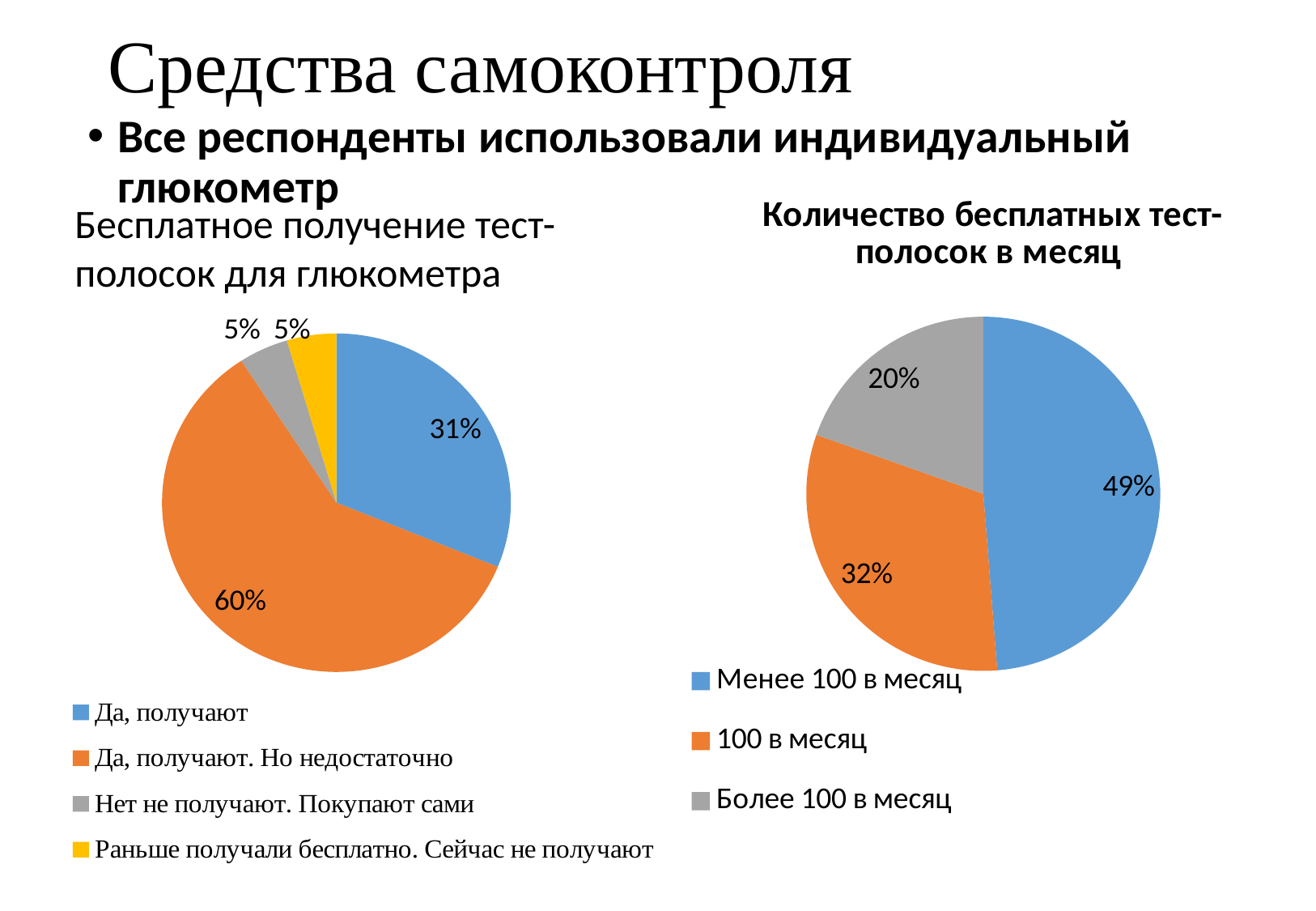
In the left chart 'Бесплатное получение тест-полосок для глюкометра', what share of respondents answered 'Да, получают'? 31% In the left chart 'Бесплатное получение тест-полосок для глюкометра', how many categories does the legend list? 4 In the right chart 'Количество бесплатных тест-полосок в месяц', which is larger: the share for '100 в месяц' or for 'Более 100 в месяц'? 100 в месяц In the left chart 'Бесплатное получение тест-полосок для глюкометра', what is the difference between the shares for 'Да, получают. Но недостаточно' and 'Да, получают'? 29% In the right chart 'Количество бесплатных тест-полосок в месяц', what share of respondents receive '100 в месяц'? 32% In the left chart 'Бесплатное получение тест-полосок для глюкометра', what share of respondents answered 'Нет не получают. Покупают сами'? 5% In the right chart 'Количество бесплатных тест-полосок в месяц', what colour is the slice for 'Более 100 в месяц'? Gray In the left chart 'Бесплатное получение тест-полосок для глюкометра', which category has the largest share? Да, получают. Но недостаточно What type of chart is the right chart 'Количество бесплатных тест-полосок в месяц'? Pie chart In the right chart 'Количество бесплатных тест-полосок в месяц', what share of respondents receive 'Менее 100 в месяц'? 49% In the right chart 'Количество бесплатных тест-полосок в месяц', which category has the smallest share? Более 100 в месяц In the left chart 'Бесплатное получение тест-полосок для глюкометра', what share of respondents answered 'Да, получают. Но недостаточно'? 60%